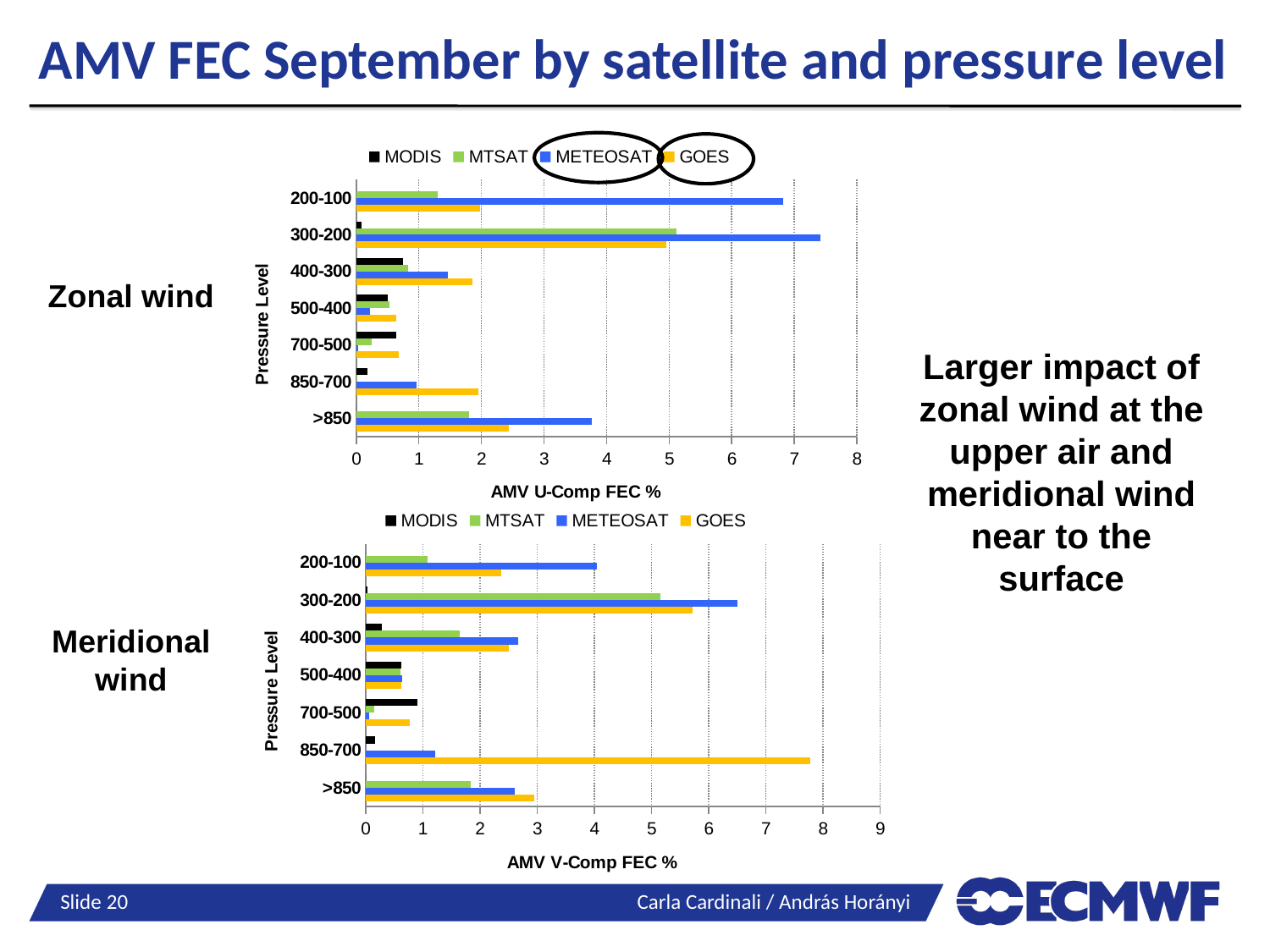
In the Zonal wind chart, at the 400-300 pressure level, which is larger: GOES or METEOSAT? GOES How many series does the legend of the Zonal wind chart list? 4 In the Zonal wind chart, is the METEOSAT value for 300-200 greater or less than 7? greater In the Meridional wind chart, is the GOES value for 850-700 greater or less than 7? greater In the Meridional wind chart, which satellite has the highest value at the 850-700 pressure level? GOES What kind of chart is the Zonal wind chart (top chart)? bar chart In the Zonal wind chart, which satellite has the lowest value at the 300-200 pressure level? MODIS In the Meridional wind chart, at which pressure level is the METEOSAT value highest? 300-200 In the Zonal wind chart, at the >850 pressure level, which is larger: METEOSAT or GOES? METEOSAT How many pressure level categories are shown on the Meridional wind chart? 7 In the Zonal wind chart, which satellite has the highest value at the 200-100 pressure level? METEOSAT What is the x-axis title of the Meridional wind chart (bottom chart)? AMV V-Comp FEC %